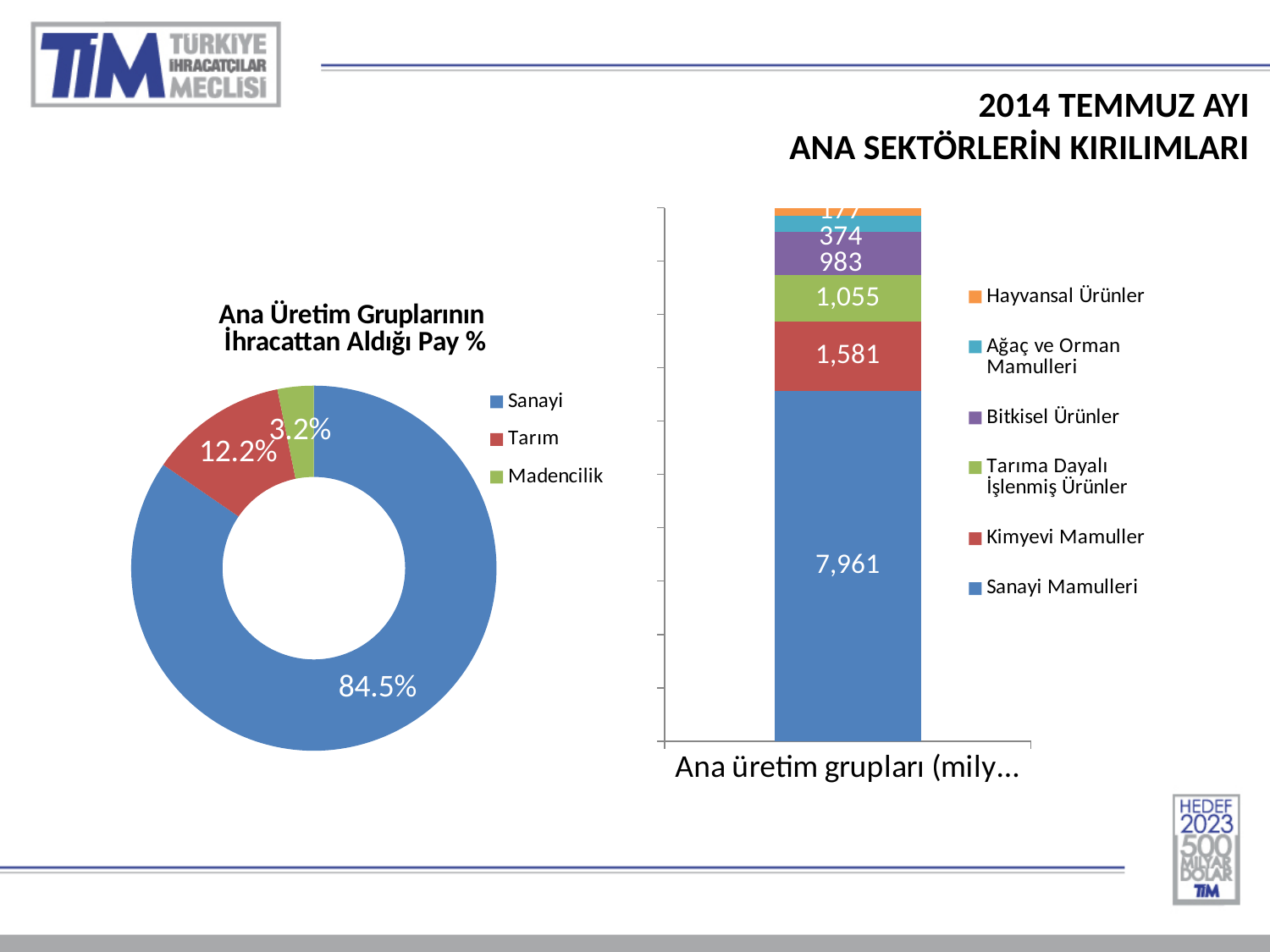
On the doughnut chart on the left, how many groups does the legend list? 3 On the doughnut chart on the left, which group has the smallest share? Madencilik On the stacked bar chart on the right, what is the value for Tarıma Dayalı İşlenmiş Ürünler? 1,055 On the doughnut chart on the left, what share does Tarım have? 12.2% On the stacked bar chart on the right, how many series does the legend list? 6 On the doughnut chart on the left, what is the difference between the shares of Tarım and Madencilik? 9.0% On the stacked bar chart on the right, what is the value for Bitkisel Ürünler? 983 On the doughnut chart titled 'Ana Üretim Gruplarının İhracattan Aldığı Pay %', what share does Sanayi have? 84.5% On the doughnut chart on the left, what share does Madencilik have? 3.2% On the stacked bar chart on the right, which is larger: Kimyevi Mamuller or Bitkisel Ürünler? Kimyevi Mamuller On the stacked bar chart on the right, what is the value for Sanayi Mamulleri? 7,961 On the stacked bar chart on the right, what is the value for Kimyevi Mamuller? 1,581